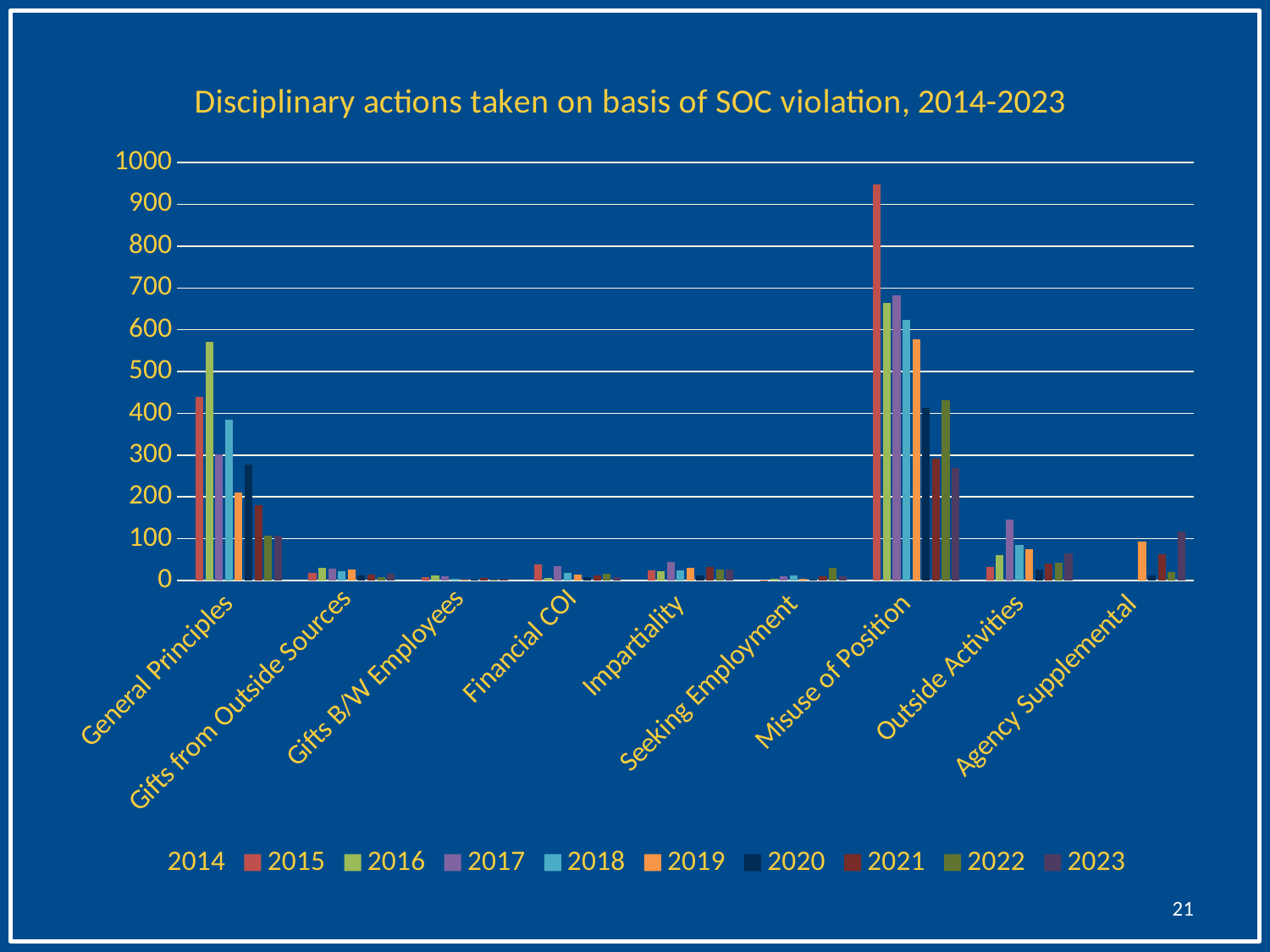
Is the value for 2016 in the General Principles category greater or less than 500? greater How many series does the legend list? 10 Is the value for 2017 in the Outside Activities category greater or less than 100? greater How many categories are shown along the x axis? 9 What kind of chart is shown on the slide? bar chart What is the title of the chart? Disciplinary actions taken on basis of SOC violation, 2014-2023 Is the value for 2015 in the Misuse of Position category greater or less than 900? greater Which category has the tallest bar in the chart? Misuse of Position